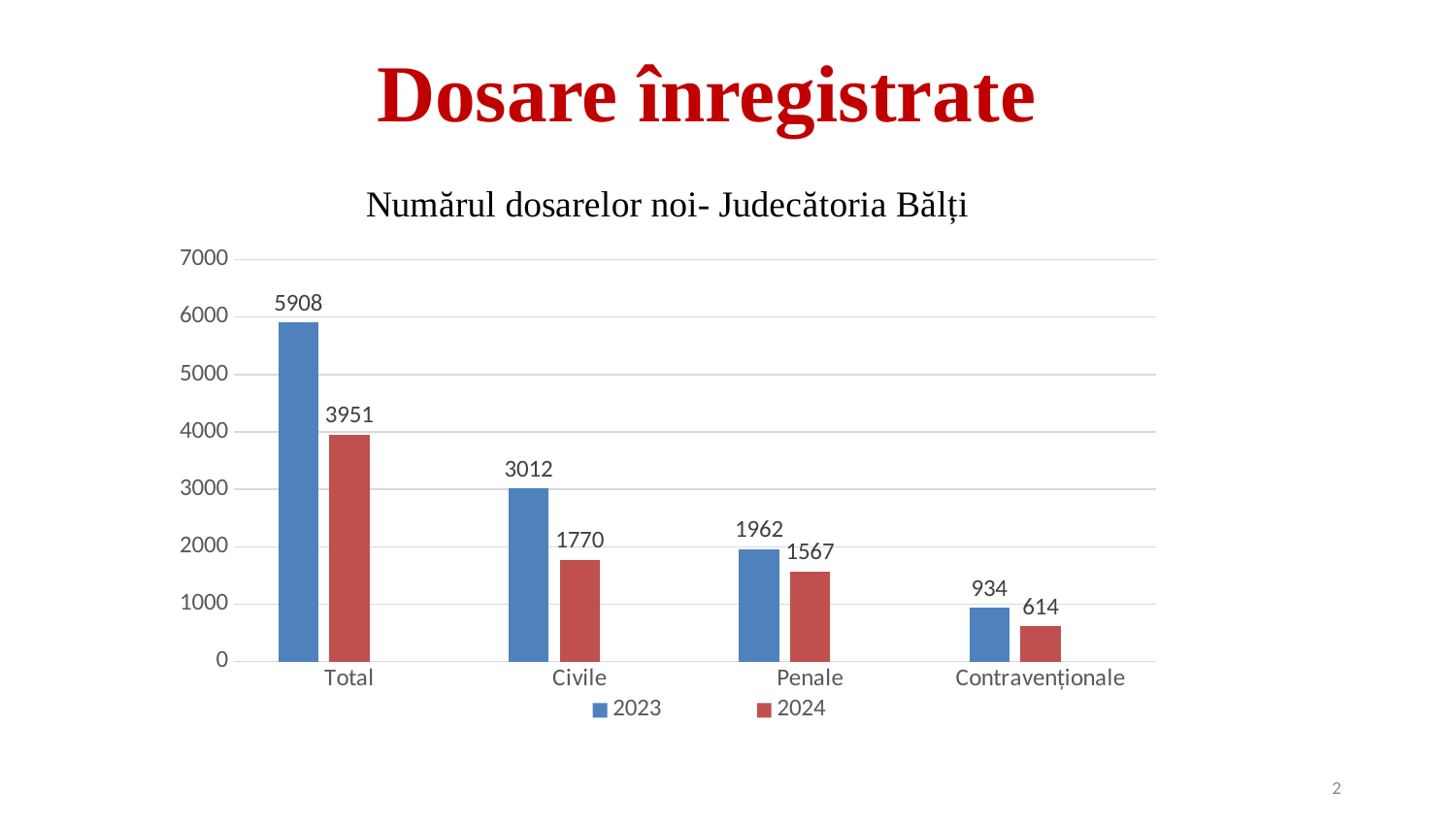
How many series does the legend list? 2 What is the difference between the 2023 and 2024 values for Civile? 1242 What is the value for Contravenționale in 2023? 934 What kind of chart is shown on the slide? Bar chart How many categories are shown on the x axis? 4 What is the value for Penale in 2024? 1567 What is the value for Civile in 2024? 1770 Which category has the lowest value in 2024? Contravenționale Excluding Total, which category has the highest value in 2023? Civile What is the difference between the 2023 and 2024 values for Total? 1957 Which is larger: the 2024 value for Civile or the 2023 value for Penale? 2023 value for Penale What is the value for Total in 2023? 5908